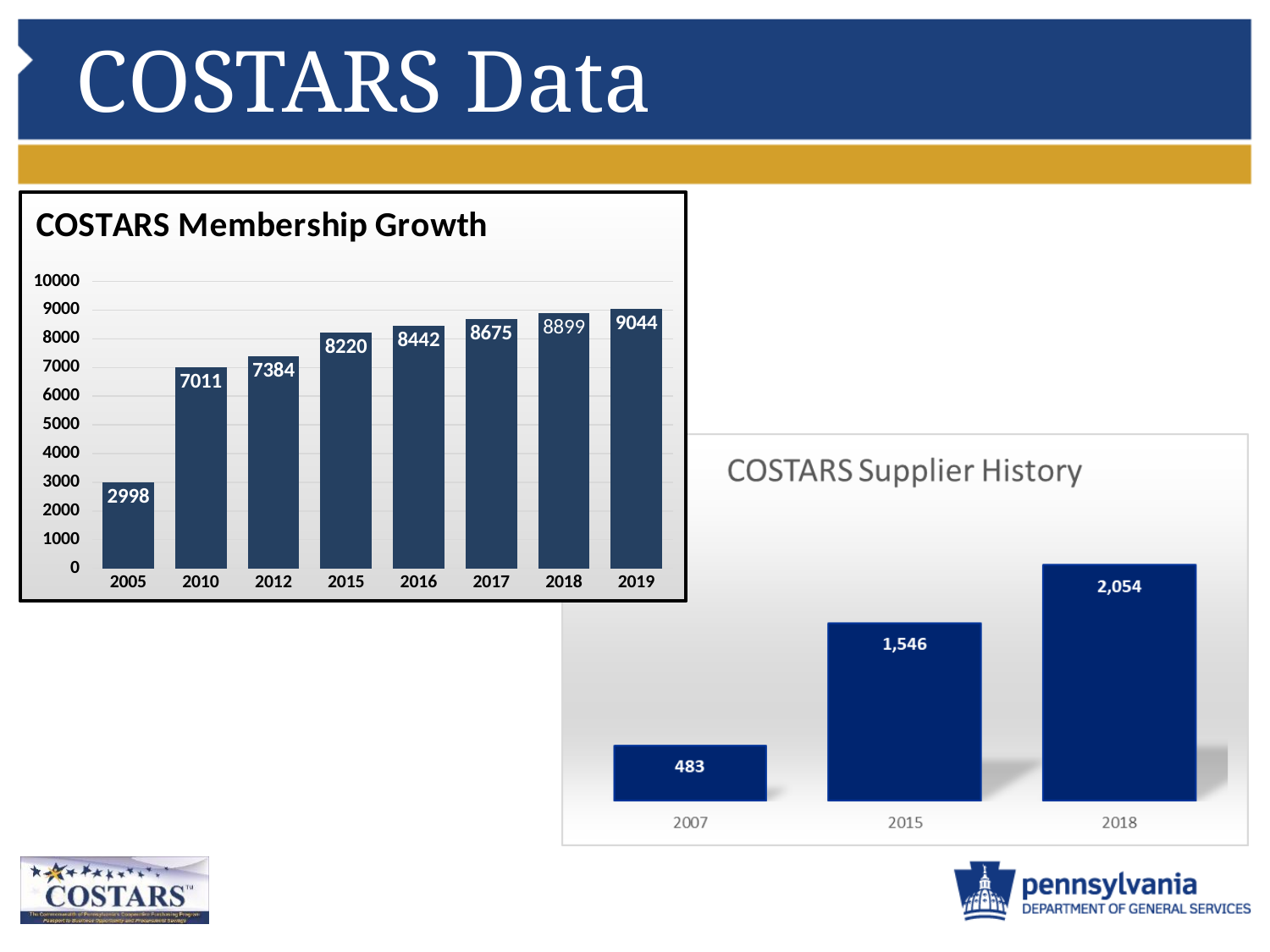
In the COSTARS Supplier History chart, what is the difference between the values for 2018 and 2015? 508 In the COSTARS Membership Growth chart, what is the value for 2005? 2998 In the COSTARS Membership Growth chart, what is the difference between the values for 2019 and 2018? 145 In the COSTARS Membership Growth chart, which year has the lowest value? 2005 In the COSTARS Supplier History chart, which is larger, the value for 2007 or the value for 2015? 2015 In the COSTARS Membership Growth chart, do the values rise or fall from 2005 to 2019? rise In the COSTARS Supplier History chart, what is the value for 2007? 483 What kind of chart is the COSTARS Supplier History chart? bar chart In the COSTARS Membership Growth chart, how many years are shown on the x axis? 8 In the COSTARS Supplier History chart, what is the value for 2015? 1,546 In the COSTARS Membership Growth chart, which year has the highest value? 2019 In the COSTARS Membership Growth chart, what is the value for 2016? 8442